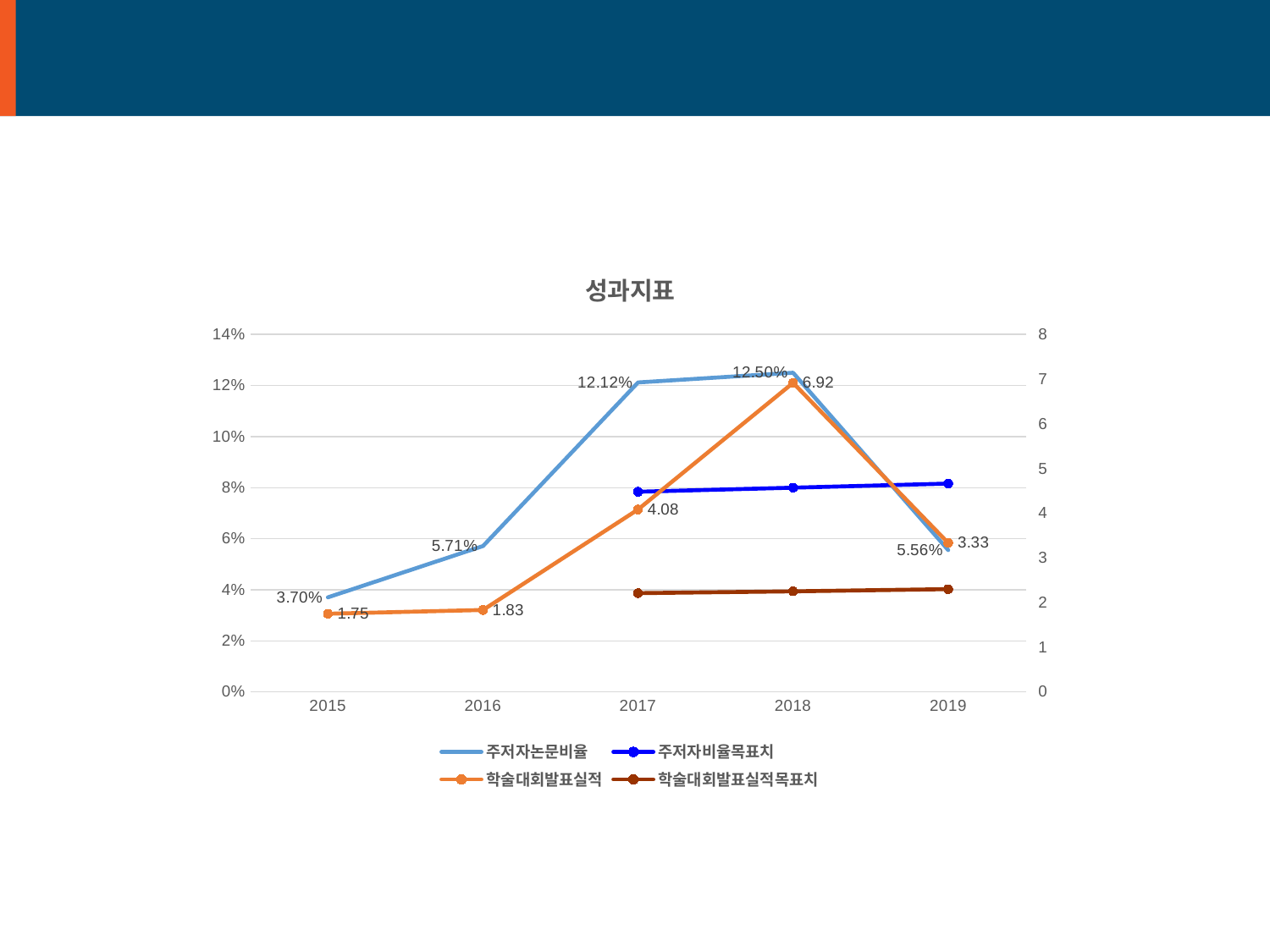
In which year is 학술대회발표실적 lowest? 2015 Which is larger, 주저자논문비율 in 2016 or in 2019? 2016 How many series does the legend list? 4 What is the value of 주저자논문비율 in 2017? 12.12% What is the difference between 학술대회발표실적 in 2018 and in 2019? 3.59 What is the value of 학술대회발표실적 in 2018? 6.92 What type of chart is shown on the slide? line chart What is the title of the chart? 성과지표 In which year is 주저자논문비율 highest? 2018 Does 주저자논문비율 rise or fall from 2018 to 2019? fall How many years are shown on the x axis? 5